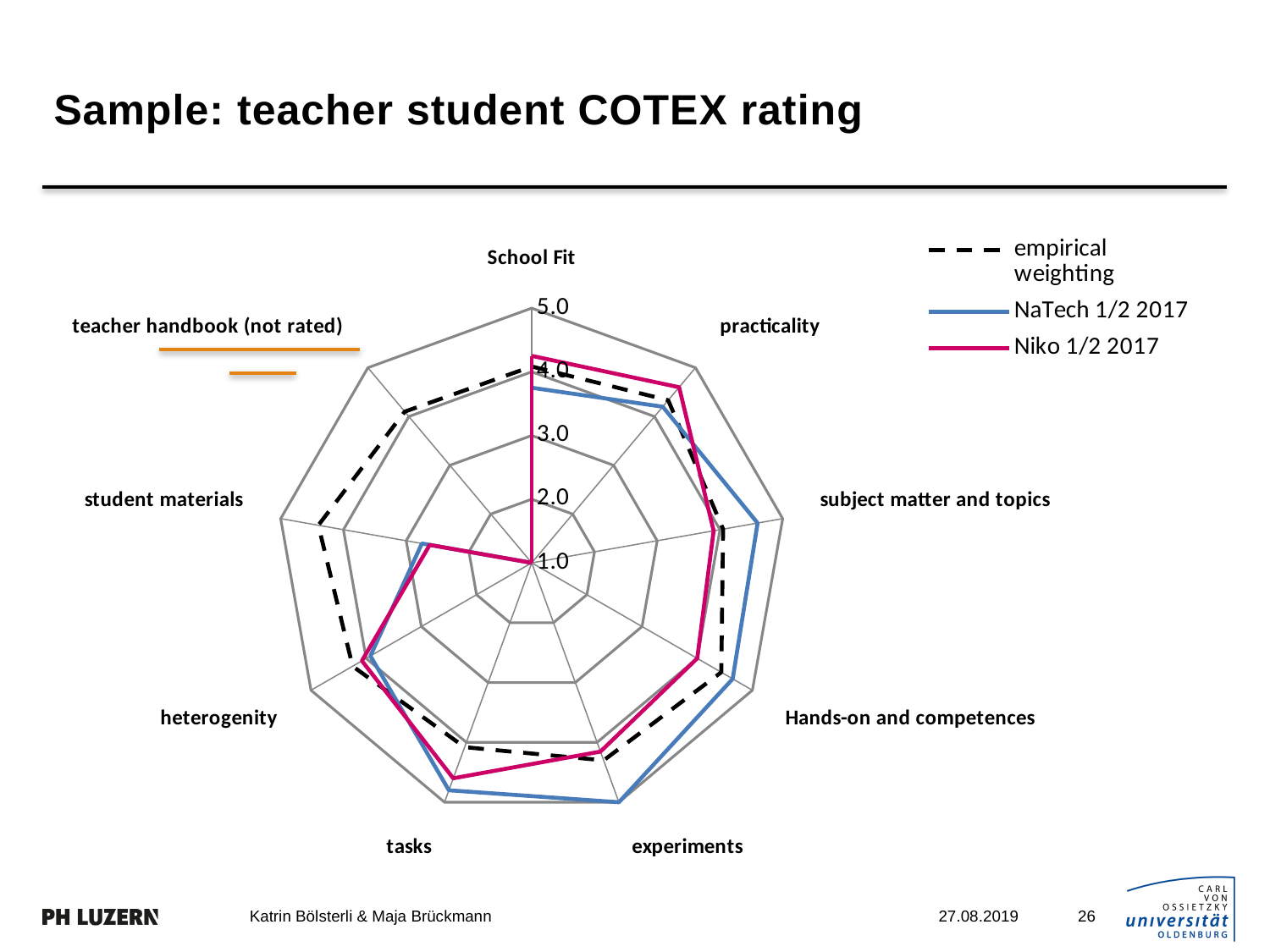
Is the NaTech 1/2 2017 value for experiments greater or less than 4.0? greater What is the highest value shown on the radial axis? 5.0 Is the empirical weighting value for teacher handbook (not rated) greater or less than 3.0? greater Which series is drawn with a dashed line? empirical weighting How many series does the legend list? 3 What kind of chart is shown on the slide? radar chart For tasks, which is larger: NaTech 1/2 2017 or empirical weighting? NaTech 1/2 2017 For Hands-on and competences, which is larger: NaTech 1/2 2017 or Niko 1/2 2017? NaTech 1/2 2017 How many category axes does the radar chart have? 9 For subject matter and topics, which is larger: NaTech 1/2 2017 or Niko 1/2 2017? NaTech 1/2 2017 Is the Niko 1/2 2017 value for student materials greater or less than 2.0? greater